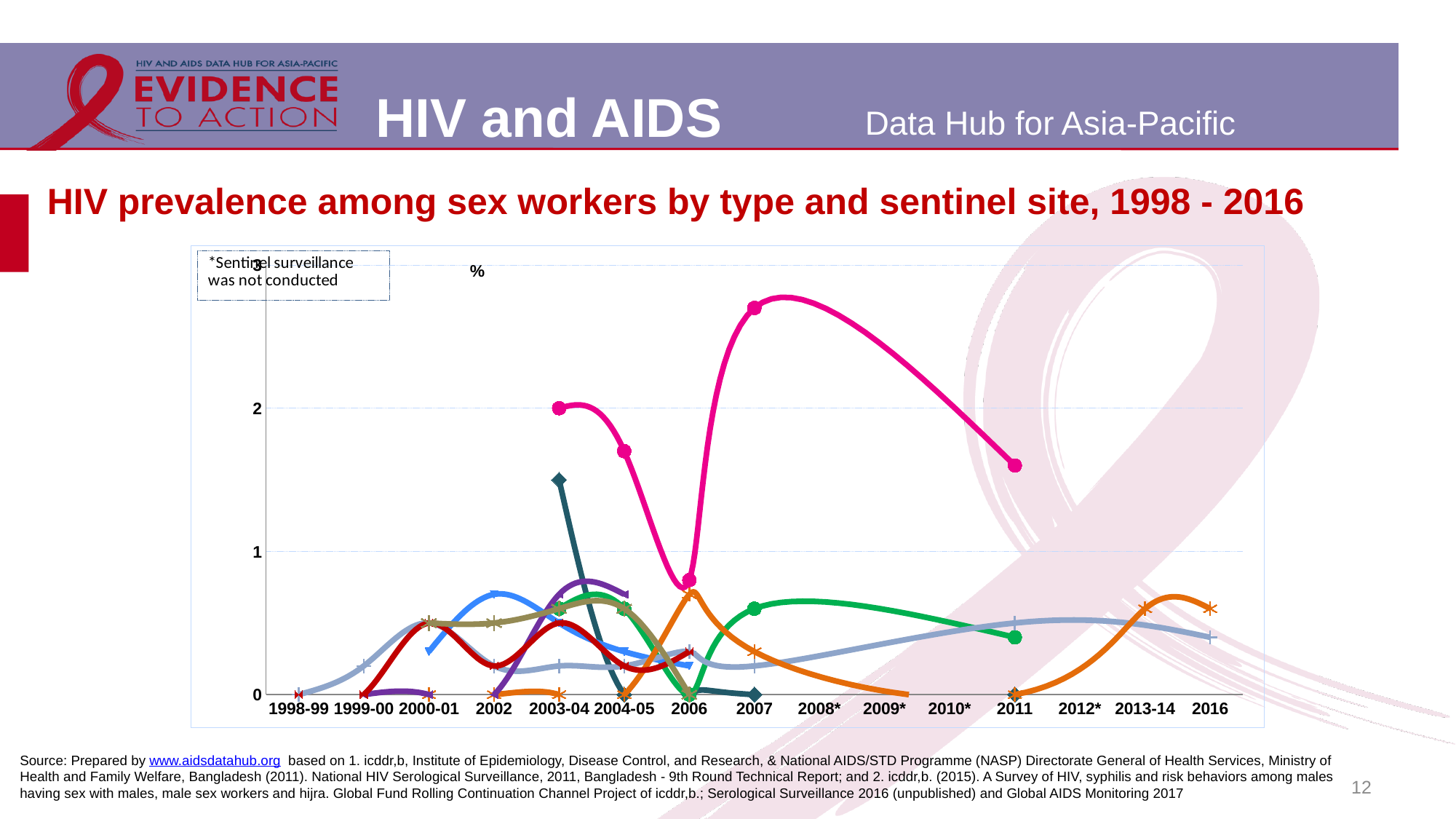
What kind of chart is shown on the slide? line chart Does the pink line rise or fall between 2007 and 2011? fall Does the dark teal line rise or fall between 2003-04 and 2004-05? fall How many time periods are labelled along the x axis of the chart? 15 What is the title of the chart on the slide? HIV prevalence among sex workers by type and sentinel site, 1998 - 2016 Which of the two is larger: the pink line's value in 2007 or its value in 2003-04? 2007 In which year does the highest point on the chart occur? 2007 How many x-axis labels on the chart are marked with an asterisk? 4 Is the value of the pink line in 2006 greater or less than 1? less Is the value of the pink line in 2011 greater or less than 2? less What is the highest value shown on the y axis of the chart? 3 Is the value of the pink line in 2007 greater or less than 2? greater